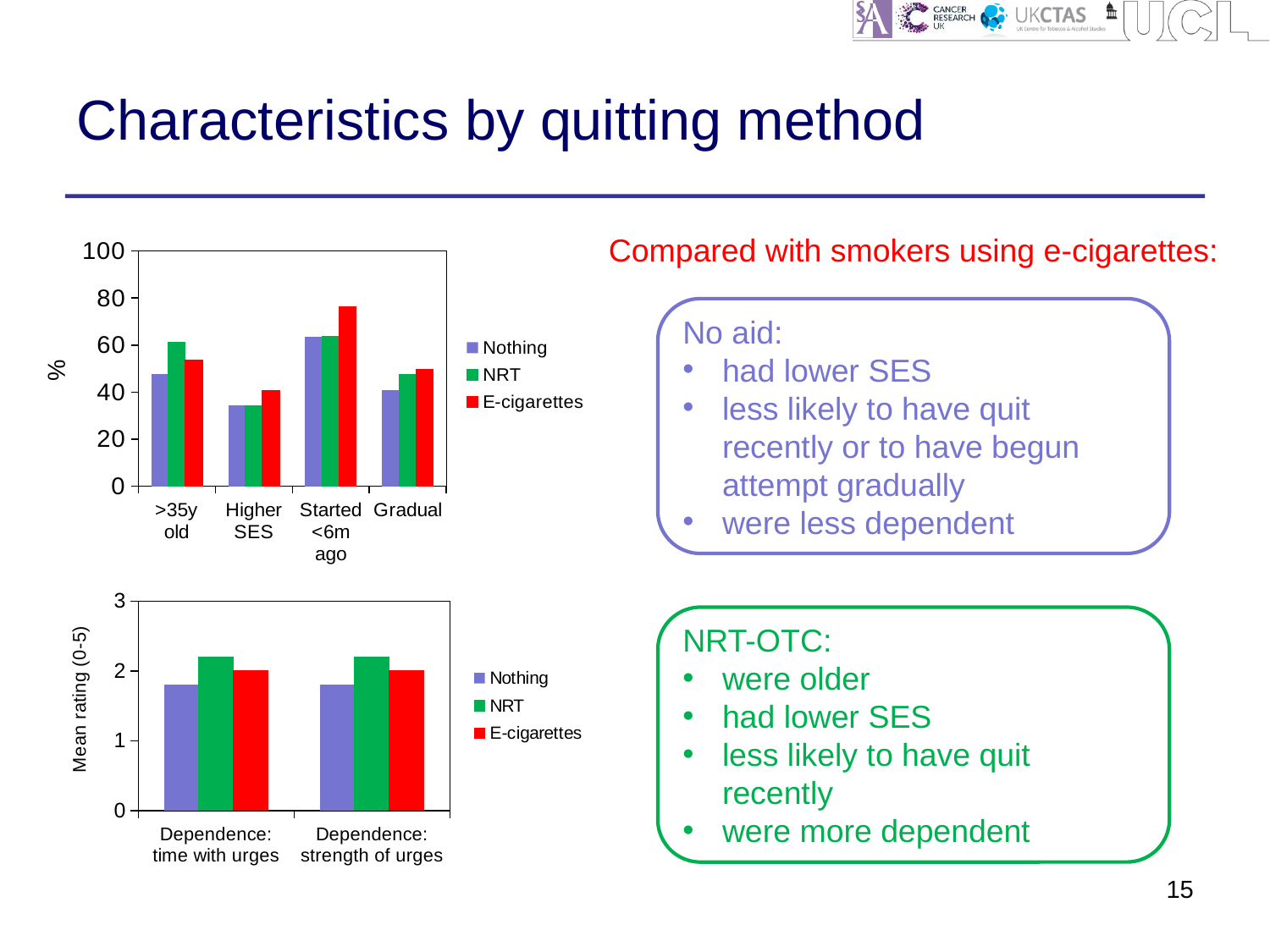
In the bottom chart, is the value for NRT in 'Dependence: strength of urges' greater or less than 2? greater In the top chart, is the value for E-cigarettes in the 'Started <6m ago' category greater or less than 60? greater In the top chart, is the value for Nothing in the '>35y old' category greater or less than 60? less In the top chart, which is larger for '>35y old': Nothing or NRT? NRT How many categories are shown on the x axis of the top chart? 4 In the top chart, which series has the highest value for 'Started <6m ago'? E-cigarettes How many categories are shown on the x axis of the bottom chart? 2 How many series does the legend of the top chart list? 3 What is the y-axis label of the bottom chart? Mean rating (0-5) What type of chart is the top chart on the slide? bar chart In the bottom chart, which series has the lowest value for 'Dependence: time with urges'? Nothing